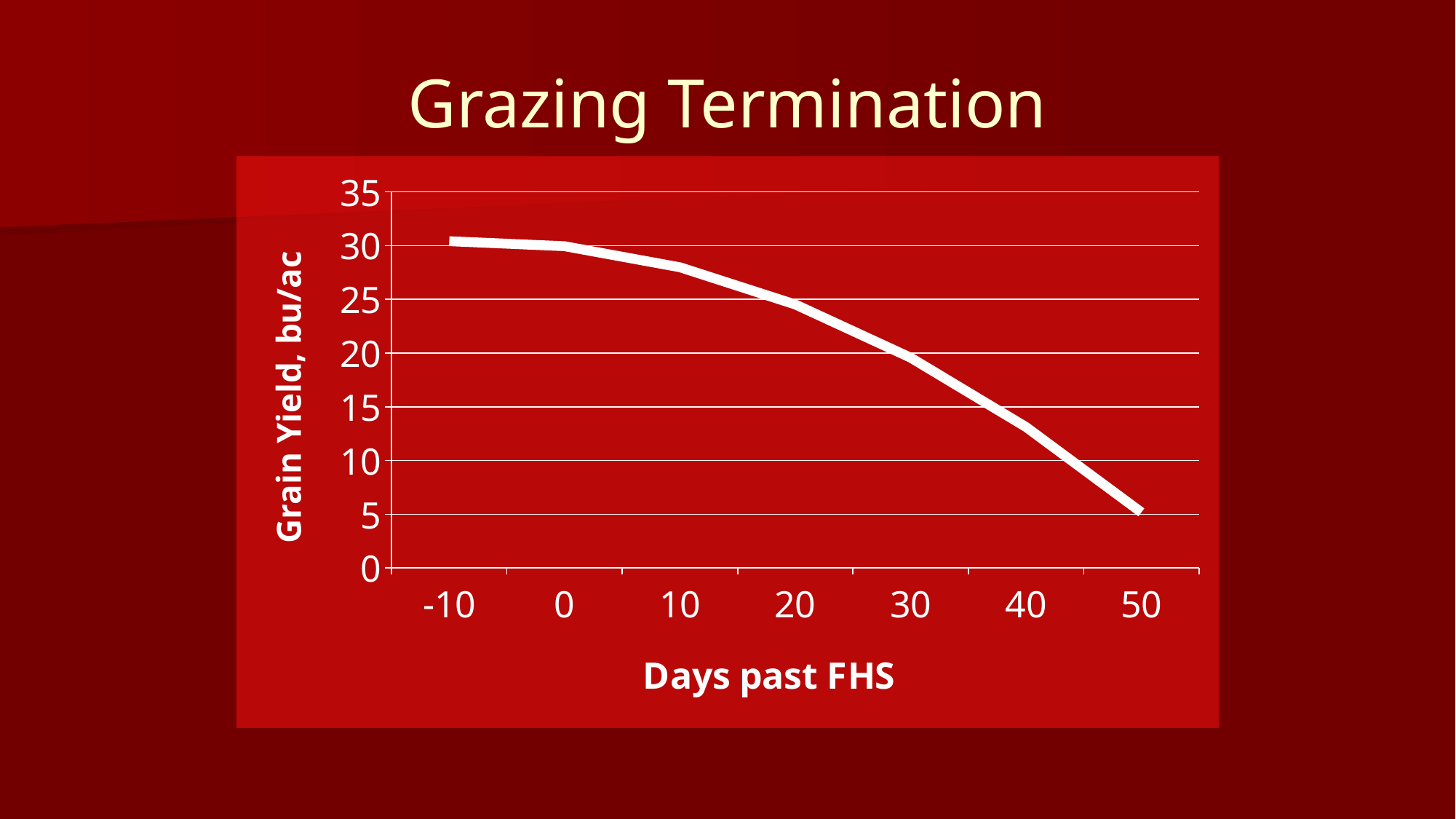
Is the grain yield at 50 days past FHS greater or less than 10? less Is the grain yield at 10 days past FHS greater or less than 25? greater What is the label of the y axis? Grain Yield, bu/ac Is the grain yield at 30 days past FHS greater or less than 25? less What kind of chart is shown on the slide? line chart Does grain yield rise or fall as days past FHS increase? fall At which value of days past FHS is grain yield lowest? 50 Which has the higher grain yield: 10 days past FHS or 40 days past FHS? 10 days past FHS What is the title of the chart? Grazing Termination How many tick labels are shown on the x axis? 7